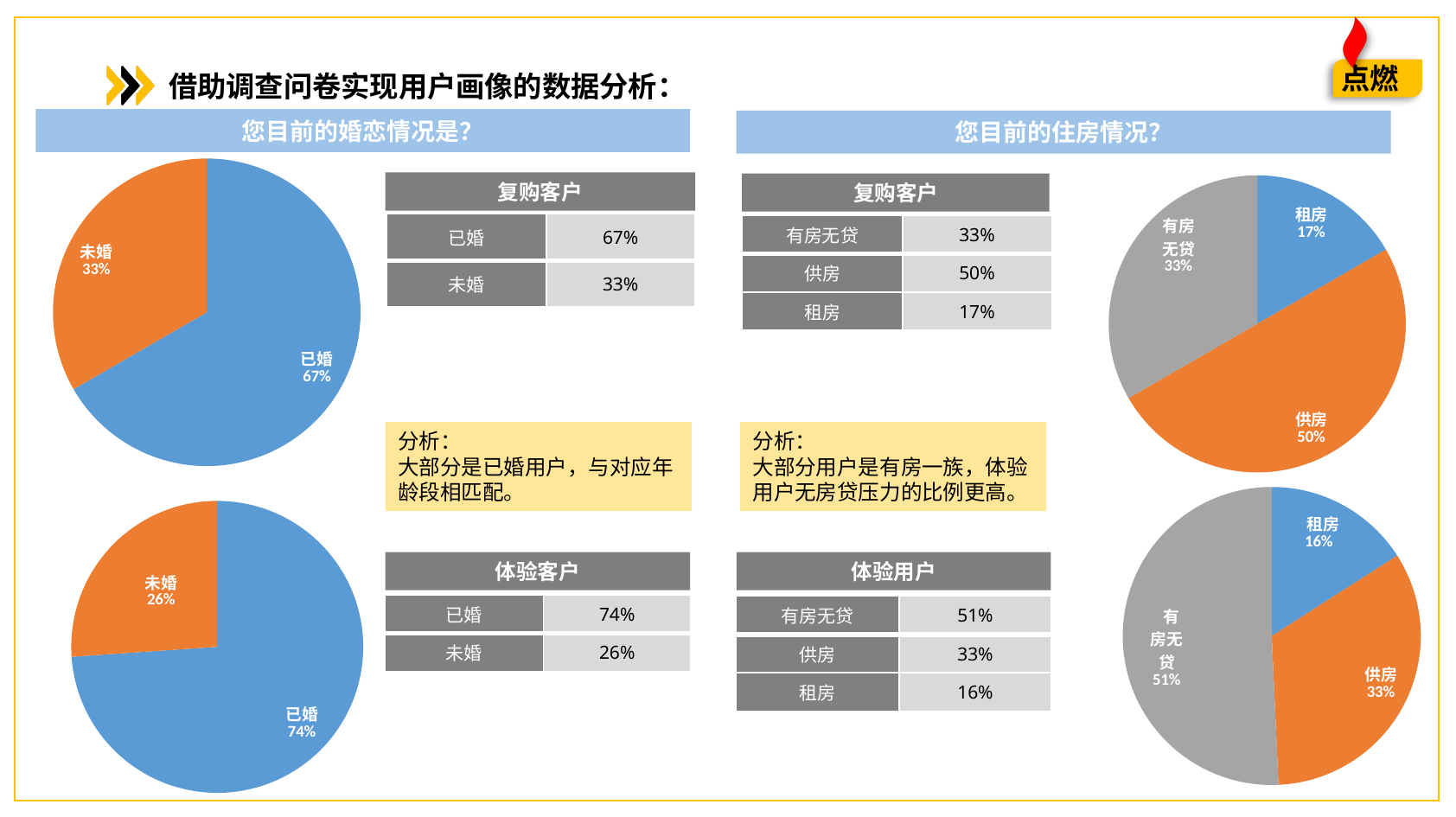
In the bottom-right pie chart (housing status of trial users), what is the difference between the 有房无贷 share and the 供房 share? 18% In the top-left pie chart (marital status of repeat customers), what share is labelled 未婚? 33% Which is larger: the 已婚 share in the top-left pie chart or the 已婚 share in the bottom-left pie chart? bottom-left (74%) In the top-right pie chart (housing status of repeat customers), how many slices are there? 3 In the bottom-left pie chart (marital status of trial customers), which slice is the smallest? 未婚 In the bottom-right pie chart (housing status of trial users), what share is labelled 有房无贷? 51% In the bottom-right pie chart (housing status of trial users), which slice is the smallest? 租房 In the top-left pie chart (marital status of repeat customers), what share is labelled 已婚? 67% In the top-right pie chart (housing status of repeat customers), which slice is the largest? 供房 What type of chart is used on this slide? Pie chart In the bottom-left pie chart (marital status of trial customers), what share is labelled 已婚? 74% In the top-right pie chart (housing status of repeat customers), what share is labelled 供房? 50%